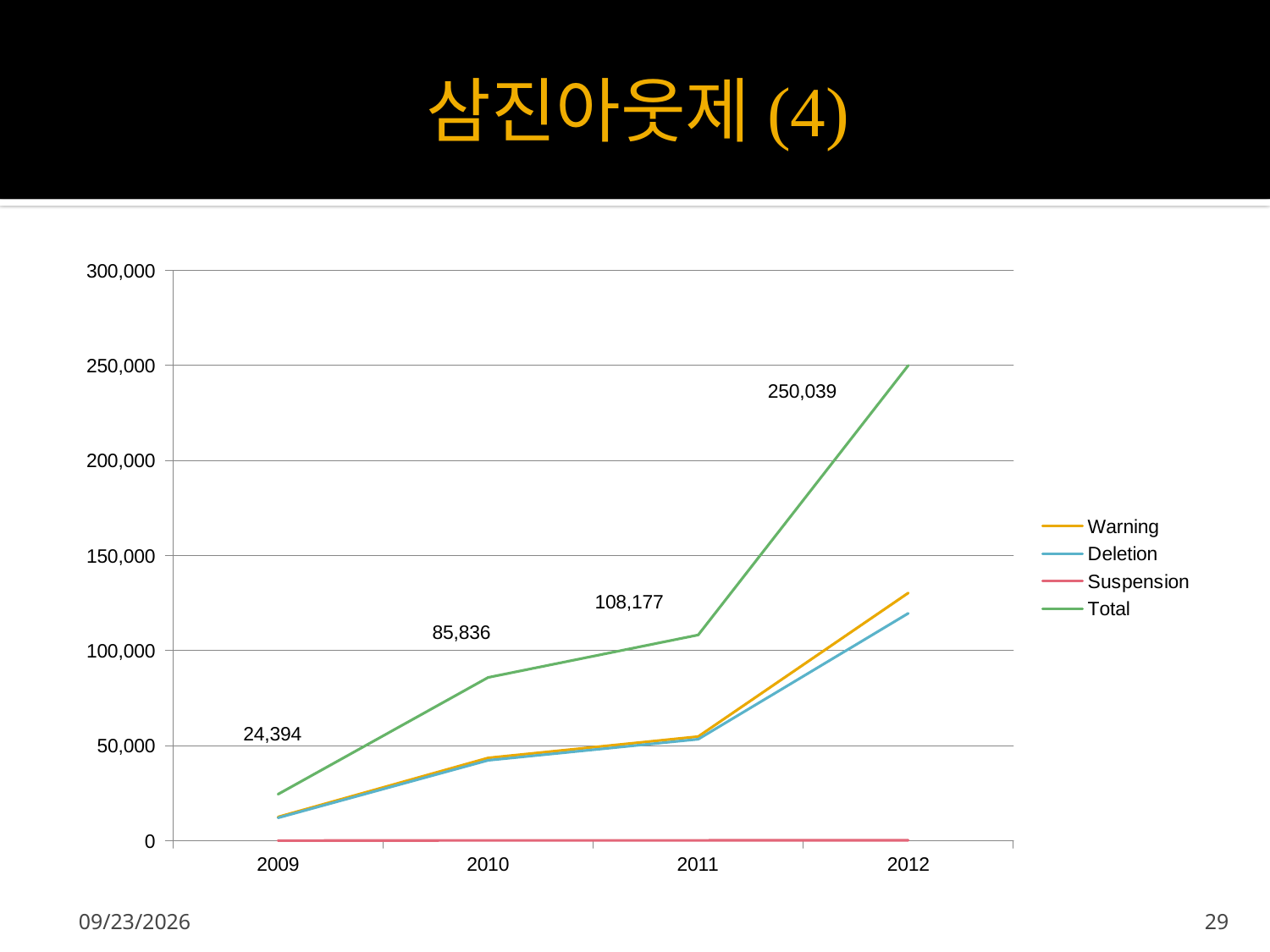
In which year is the Total series highest? 2012 What is the difference between the Total values for 2010 and 2009? 61,442 What kind of chart is shown on the slide? line chart In which year is the Total series lowest? 2009 What is the value of the Total series in 2011? 108,177 Is the Deletion value for 2012 greater or less than 100,000? greater How many series does the legend list? 4 Does the Total series rise or fall from 2009 to 2012? rise What is the value of the Total series in 2009? 24,394 What is the value of the Total series in 2012? 250,039 What is the difference between the Total values for 2012 and 2011? 141,862 Is the Warning value for 2012 greater or less than 150,000? less